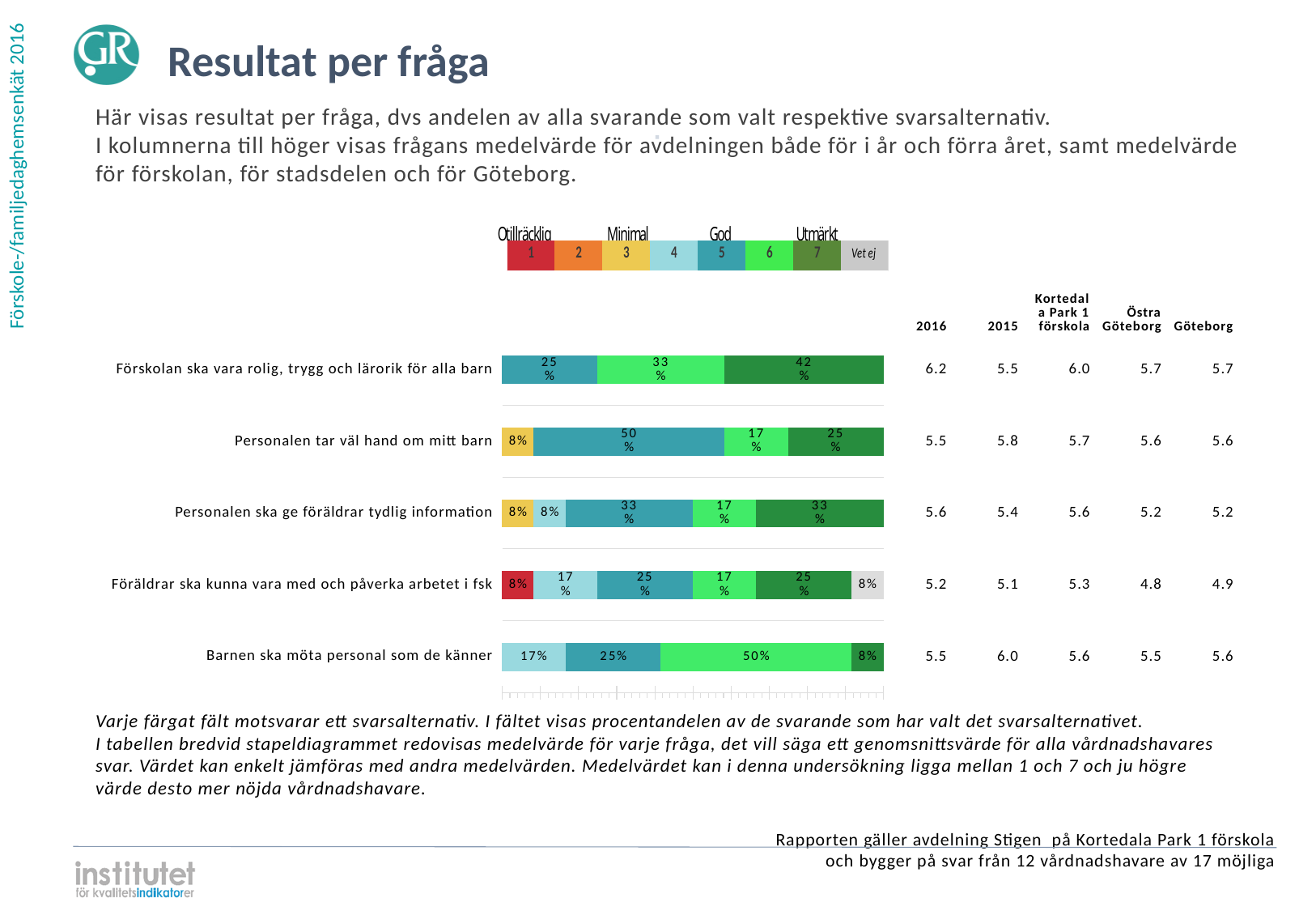
For 'Personalen ska ge föräldrar tydlig information', is the share choosing answer 5 or the share choosing answer 6 larger? Answer 5 (33%) What share of respondents chose answer 6 (light green) for 'Barnen ska möta personal som de känner'? 50% Which question is the only one with a red segment (answer 1)? Föräldrar ska kunna vara med och påverka arbetet i fsk What kind of chart is shown on the slide? Stacked bar chart What is the difference between the share choosing answer 7 and the share choosing answer 5 for 'Förskolan ska vara rolig, trygg och lärorik för alla barn'? 17% What share of respondents answered 'Vet ej' for 'Föräldrar ska kunna vara med och påverka arbetet i fsk'? 8% How many answer alternatives does the legend above the chart list? 8 What share of respondents chose answer 5 (teal) for 'Personalen tar väl hand om mitt barn'? 50% What share of respondents chose answer 7 (dark green) for 'Förskolan ska vara rolig, trygg och lärorik för alla barn'? 42% How many questions (categories) are plotted in the bar chart? 5 Which question has the largest share of respondents choosing answer 7 (dark green)? Förskolan ska vara rolig, trygg och lärorik för alla barn What is the total of the segments in the bar for 'Personalen tar väl hand om mitt barn'? 100%